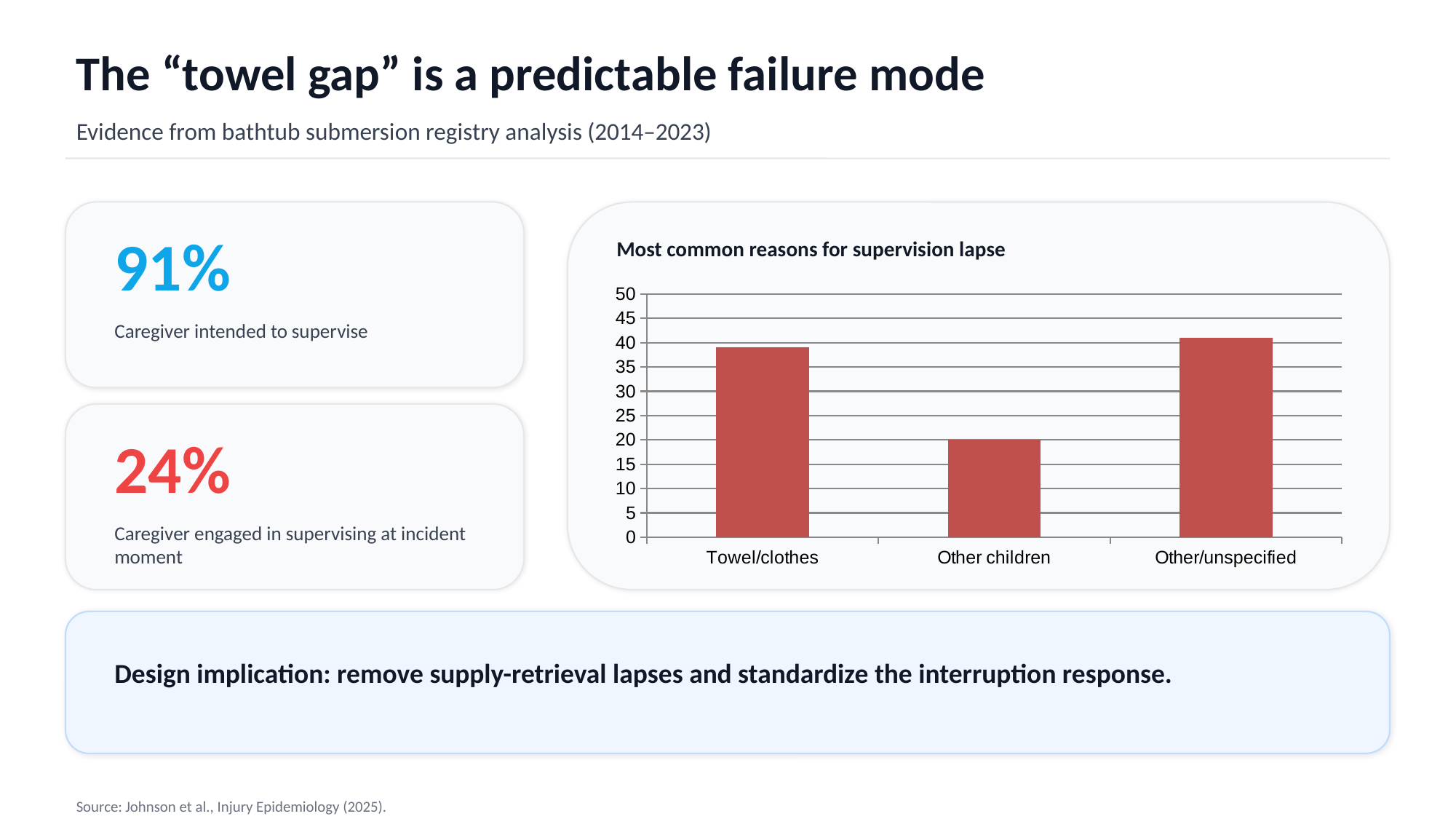
What is the title of the chart? Most common reasons for supervision lapse Which category has the lowest value in the chart? Other children Which is larger, the value for Towel/clothes or the value for Other children? Towel/clothes What kind of chart is shown on the slide? bar chart How many categories are shown on the x axis of the chart? 3 Which category has the highest value in the chart? Other/unspecified What is the highest value shown on the chart's vertical axis? 50 Is the value for Other children greater or less than 30? less Is the value for Towel/clothes greater or less than 30? greater What is the value for Other children? 20